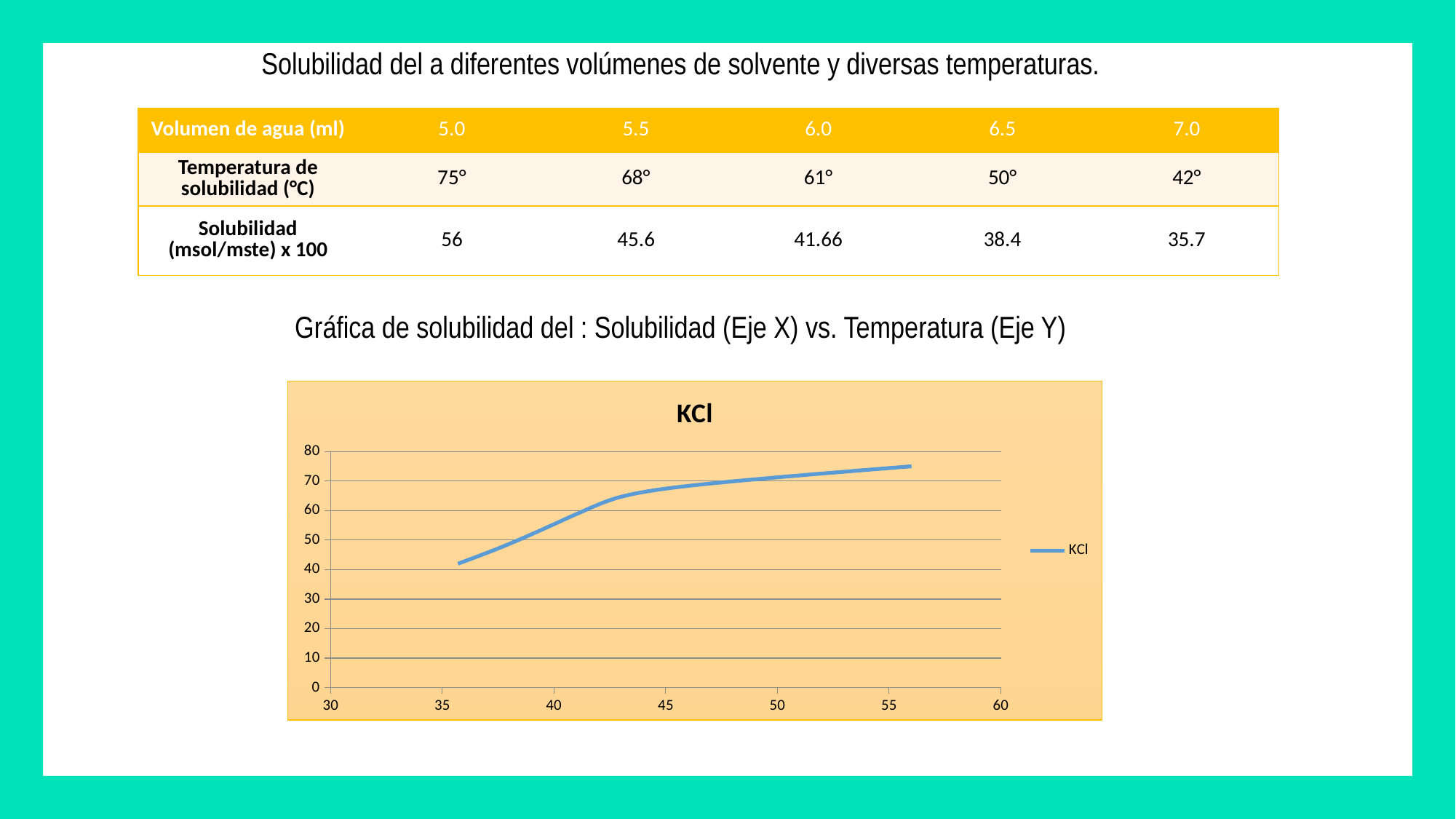
What kind of chart is the KCl chart? line chart How many series does the legend of the KCl chart list? 1 In the KCl chart, is the value of the line at x = 40 greater or less than 60? less In the KCl chart, is the value at the right end of the line greater or less than 70? greater In the KCl chart, is the value at the left end of the line higher or lower than the value at the right end? lower In the KCl chart, is the value of the line at x = 40 greater or less than 50? greater What is the title of the chart on the slide? KCl In the KCl chart, do the values rise or fall as you move from left to right along the x axis? rise What is the highest value shown on the x axis of the KCl chart? 60